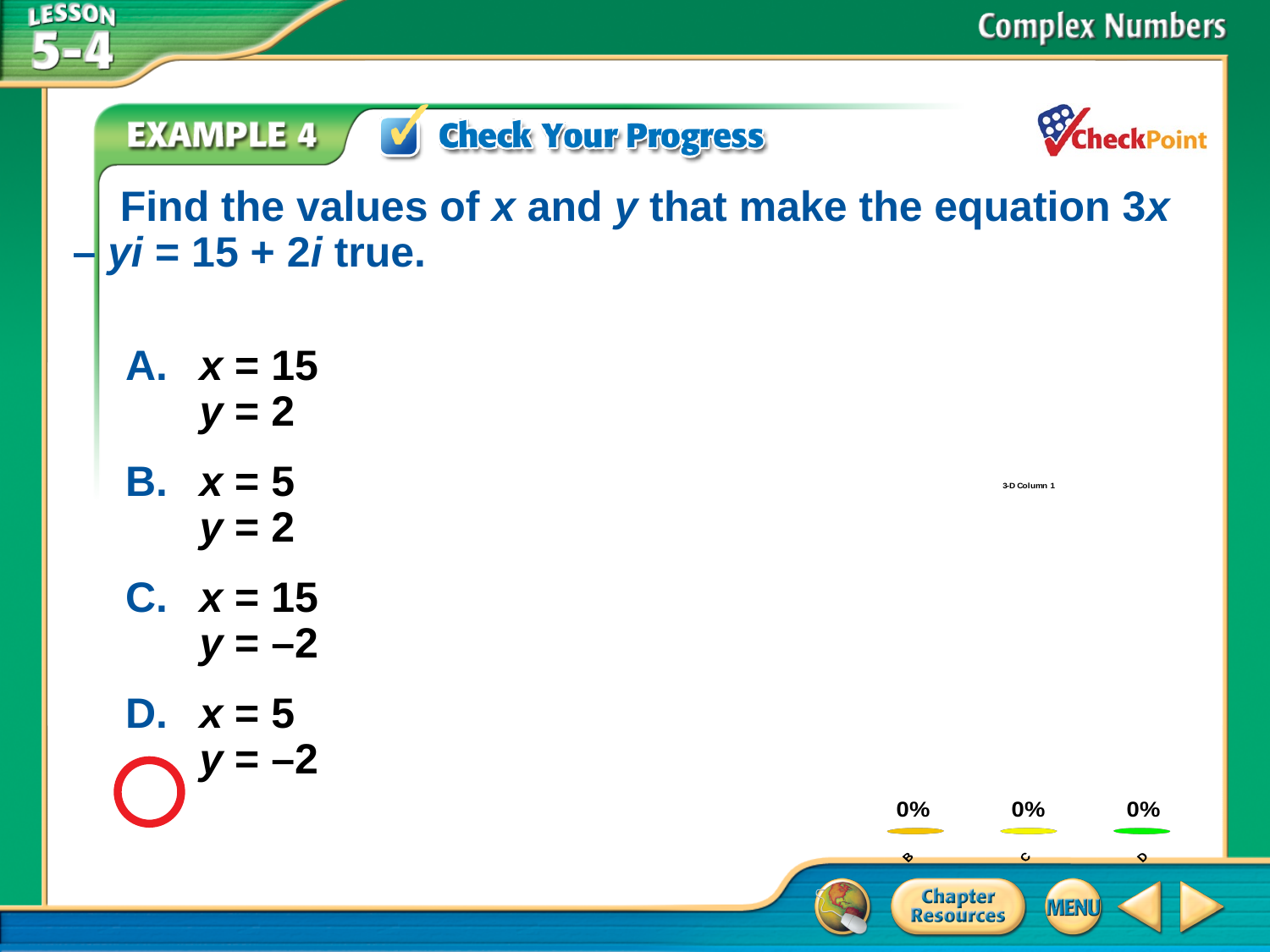
What value is shown for category C in the chart? 0% What value is shown for category B in the chart? 0% What kind of chart is shown on the slide? bar chart Is the value for category C in the chart greater or less than 50%? less What value is shown for category D in the chart? 0% Do the values in the chart rise, fall, or stay flat from B to D? stay flat What is the difference between the values for B and D in the chart? 0% How many data labels are shown on the chart? 3